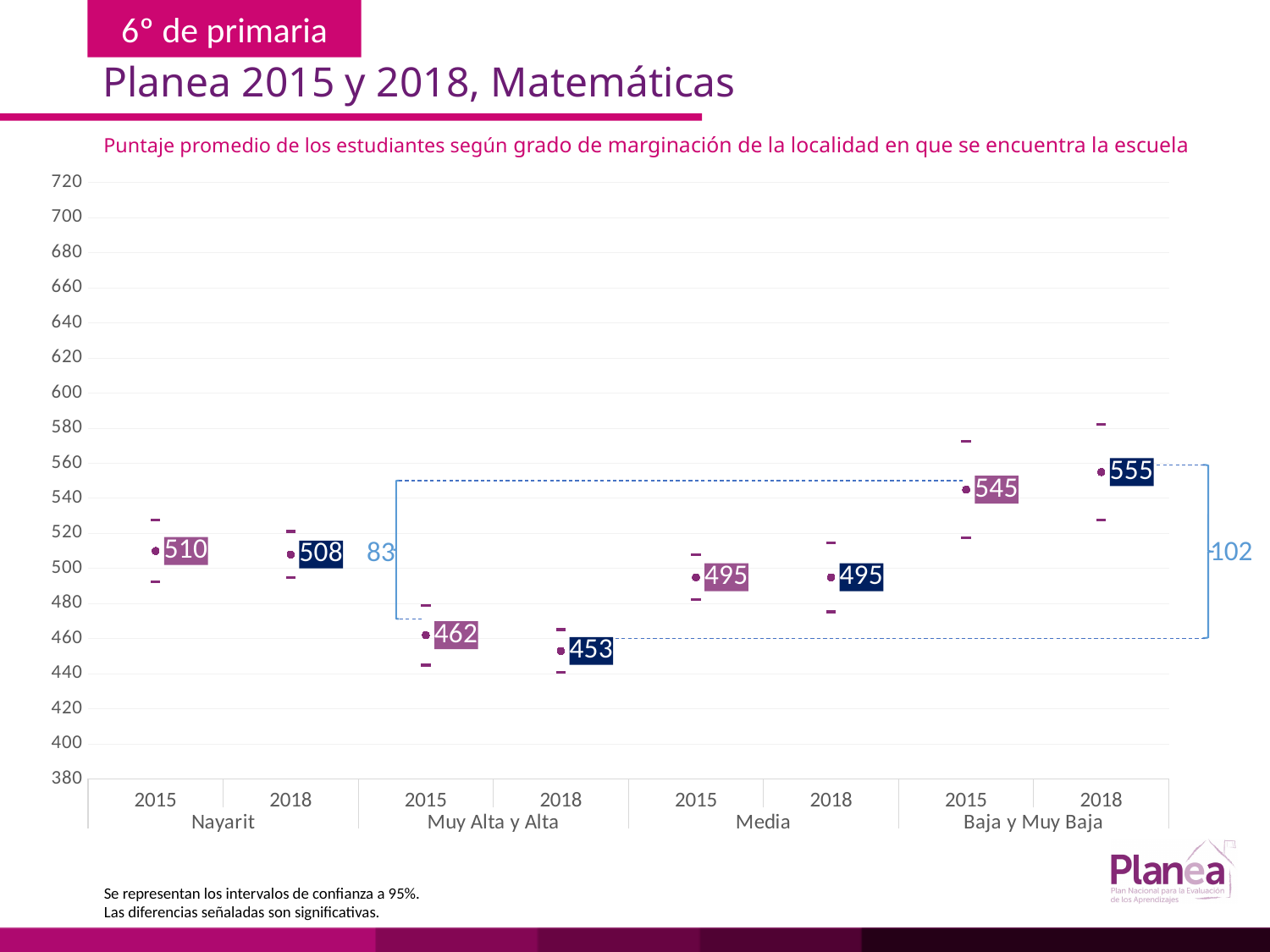
What confidence level do the intervals shown on the chart represent? 95% What is the average score for Media in 2015? 495 What is the average score for Baja y Muy Baja in 2018? 555 What is the difference between the 2018 scores of Baja y Muy Baja and Muy Alta y Alta? 102 Which group and year has the lowest average score? Muy Alta y Alta, 2018 Which group and year has the highest average score? Baja y Muy Baja, 2018 What is the average score for Muy Alta y Alta in 2018? 453 Did the Media score change between 2015 and 2018? No, it stayed at 495 What is the average score for Nayarit in 2015? 510 What is the difference between the 2015 scores of Baja y Muy Baja and Muy Alta y Alta? 83 How many data points are plotted on the chart? 8 Which is larger, the Nayarit score in 2015 or in 2018? 2015